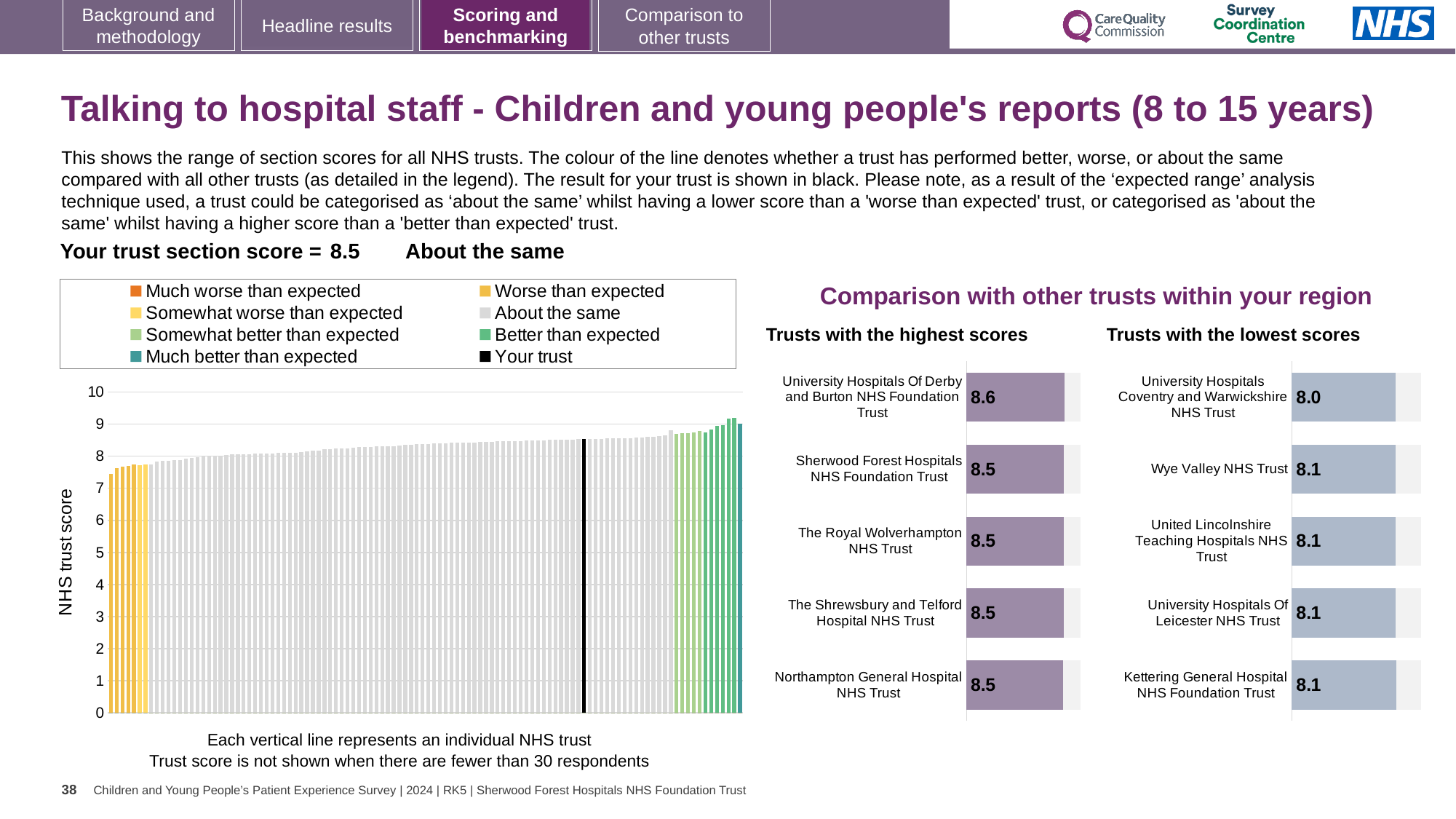
In the 'Trusts with the highest scores' chart, what is the difference between the score for University Hospitals Of Derby and Burton NHS Foundation Trust and the score for Sherwood Forest Hospitals NHS Foundation Trust? 0.1 In the 'Trusts with the highest scores' chart, what is the score for University Hospitals Of Derby and Burton NHS Foundation Trust? 8.6 What kind of chart is the main 'NHS trust score' chart on the left? Bar chart Which is larger: the score for University Hospitals Of Derby and Burton NHS Foundation Trust in the 'Trusts with the highest scores' chart, or the score for Kettering General Hospital NHS Foundation Trust in the 'Trusts with the lowest scores' chart? University Hospitals Of Derby and Burton NHS Foundation Trust In the main 'NHS trust score' chart on the left, is the value for the black 'Your trust' bar greater or less than 8? greater In the 'Trusts with the lowest scores' chart, which trust has the lowest score? University Hospitals Coventry and Warwickshire NHS Trust How many trusts are listed in the 'Trusts with the highest scores' chart? 5 In the 'Trusts with the lowest scores' chart, what is the score for Wye Valley NHS Trust? 8.1 How many entries does the legend of the main 'NHS trust score' chart on the left list? 8 In the 'Trusts with the highest scores' chart, which trust has the highest score? University Hospitals Of Derby and Burton NHS Foundation Trust How many trusts are listed in the 'Trusts with the lowest scores' chart? 5 In the 'Trusts with the lowest scores' chart, what is the score for University Hospitals Coventry and Warwickshire NHS Trust? 8.0